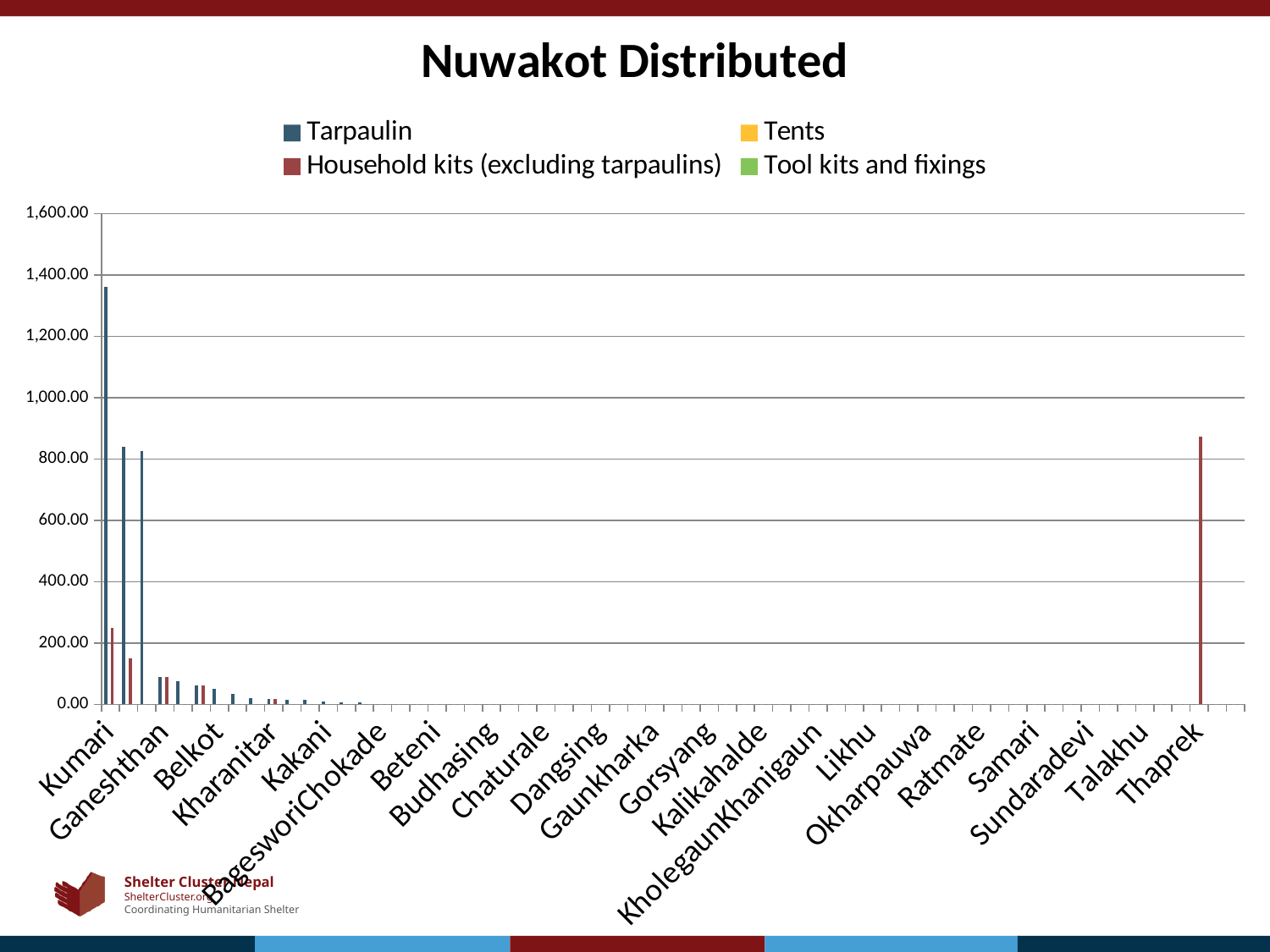
Which category has the highest Tarpaulin value? Kumari Which series is shown in red in the legend? Household kits (excluding tarpaulins) Is the Household kits (excluding tarpaulins) value for Kumari greater or less than 400.00? less What is the title of the chart? Nuwakot Distributed What kind of chart is shown on the slide? bar chart Is the Household kits (excluding tarpaulins) value for Thaprek greater or less than 1,000.00? less Is the Tarpaulin value for Kumari greater or less than 1,200.00? greater Which category has the highest Household kits (excluding tarpaulins) value? Thaprek How many series does the legend list? 4 Which is larger: the Tarpaulin value for Kumari or the Household kits (excluding tarpaulins) value for Thaprek? Tarpaulin value for Kumari